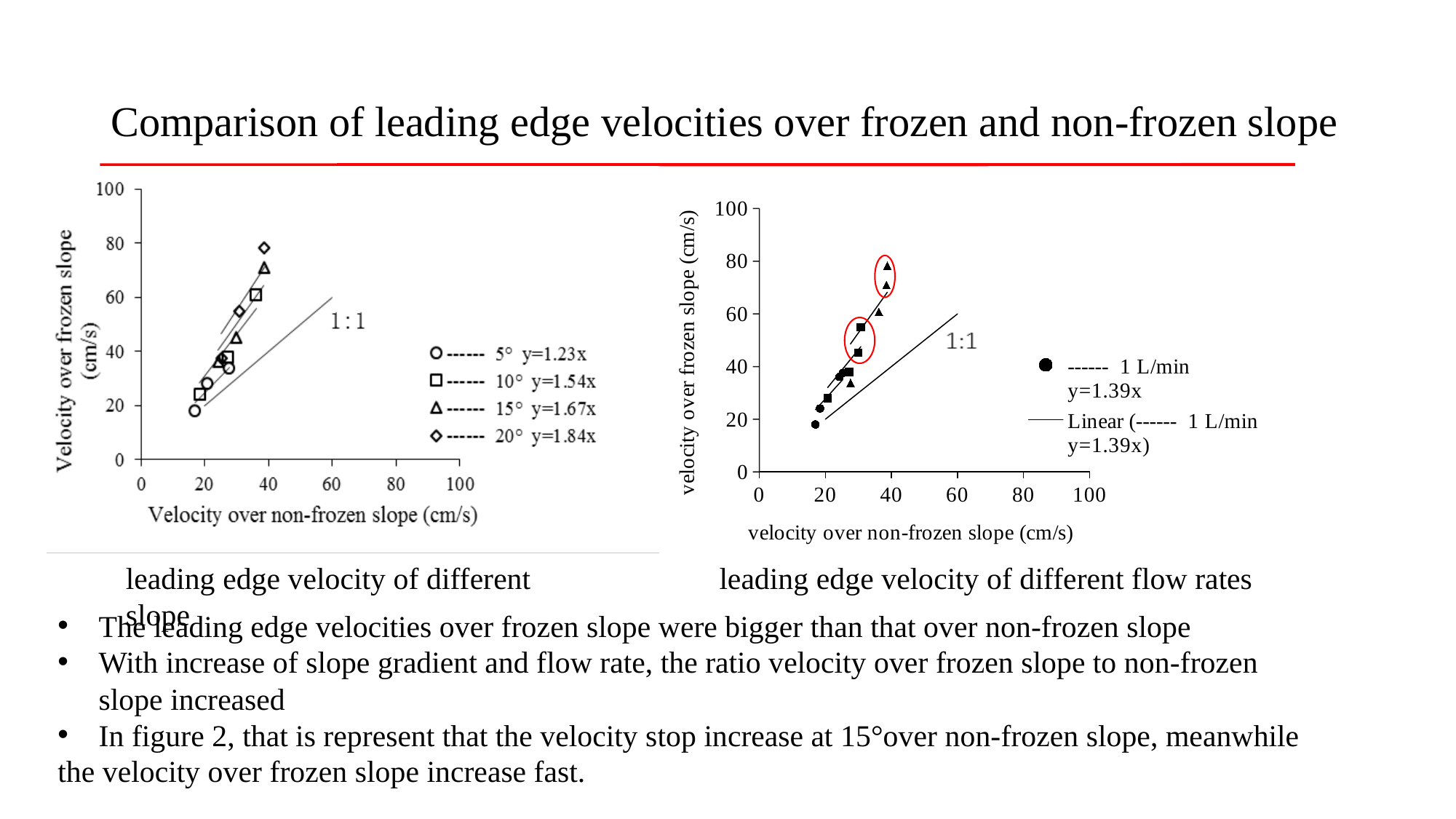
In the left chart (different slope), which slope angle has the smallest fitted slope coefficient? 5° In the left chart (different slope), what is the difference between the fitted slope coefficients of the 20° and 5° series? 0.61 In the right chart (different flow rates), is the highest plotted velocity over frozen slope greater or less than 60 cm/s? greater What kind of chart is the left chart, 'leading edge velocity of different slope'? scatter chart In the left chart (different slope), what is the fitted equation shown for the 20° series? y=1.84x In the right chart (different flow rates), what is the fitted equation shown for the 1 L/min series? y=1.39x In the left chart (different slope), what is the fitted equation shown for the 10° series? y=1.54x How many entries does the legend of the right chart (different flow rates) list? 2 How many series does the legend of the left chart (different slope) list? 4 In the right chart (different flow rates), does the velocity over frozen slope rise or fall as the velocity over non-frozen slope increases? rise In the left chart (different slope), which slope angle has the largest fitted slope coefficient? 20° In the left chart (different slope), which has the larger fitted slope coefficient, the 15° series or the 10° series? 15°